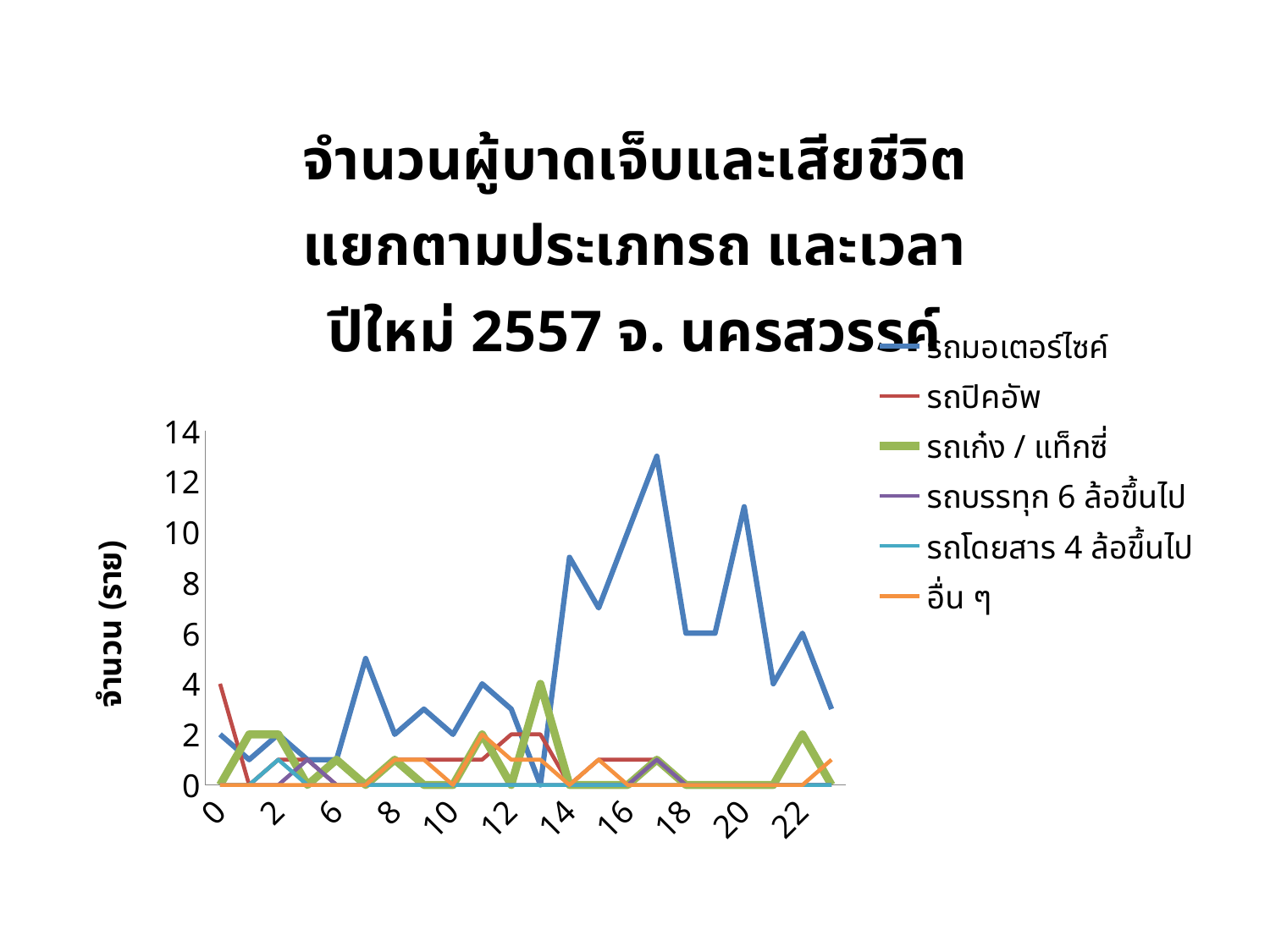
What is the value for รถปิคอัพ at hour 0? 4 Which series reaches the highest value on the chart? รถมอเตอร์ไซค์ Does the รถมอเตอร์ไซค์ line rise or fall between hour 13 and hour 17? rise Which is larger at hour 17: the value for รถมอเตอร์ไซค์ or the value for รถปิคอัพ? รถมอเตอร์ไซค์ At which hour does the รถมอเตอร์ไซค์ line reach its peak? 17 What is the value for รถเก๋ง / แท็กซี่ at hour 13? 4 Is the value for รถมอเตอร์ไซค์ at hour 17 greater or less than 12? greater What kind of chart is shown on the slide? line chart What is the label on the vertical axis? จำนวน (ราย) Is the value for รถมอเตอร์ไซค์ at hour 20 greater or less than 10? greater How many series does the legend list? 6 Is the value for รถมอเตอร์ไซค์ at hour 7 greater or less than 4? greater